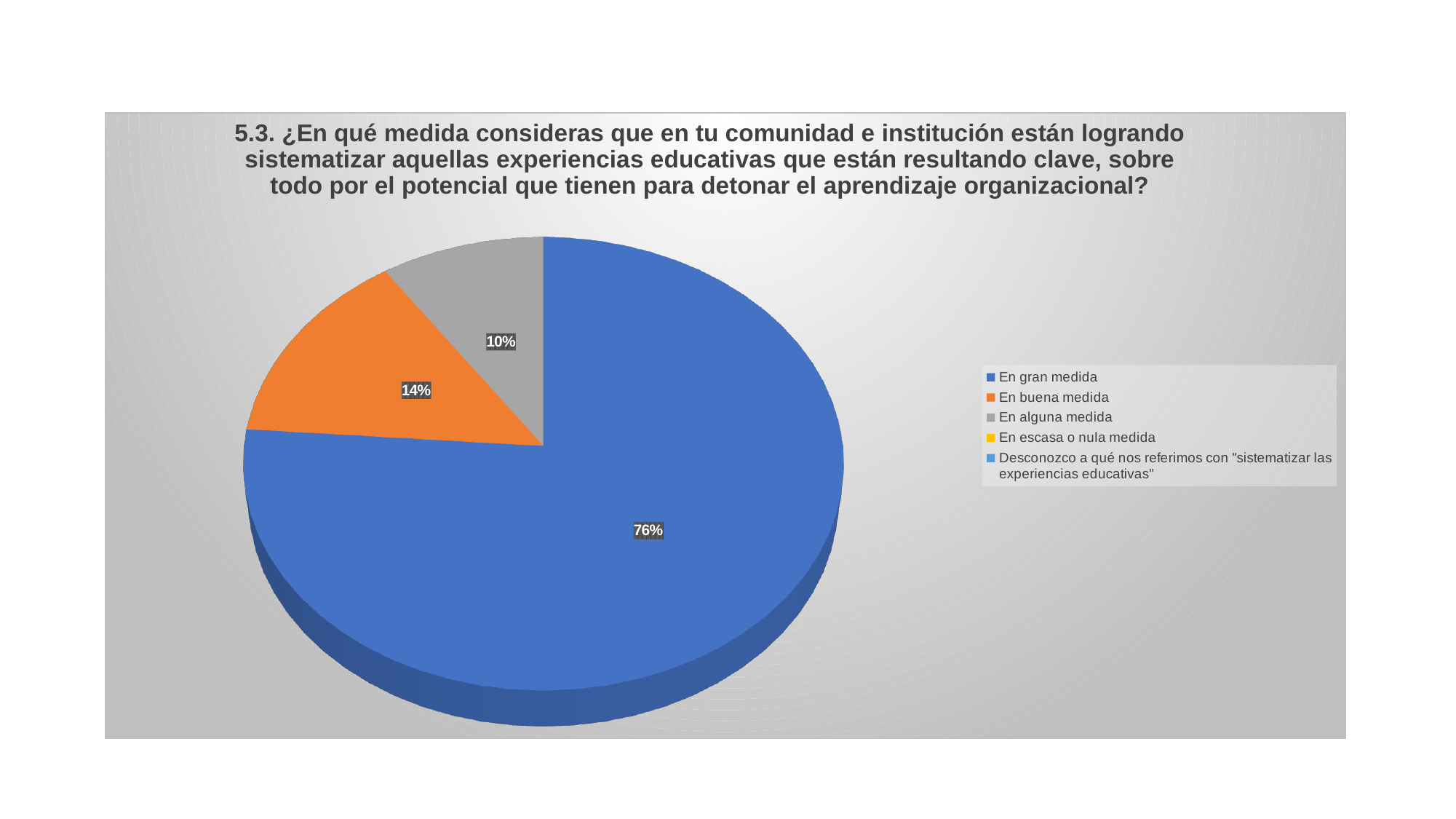
How many entries does the legend list? 5 Which is larger, the slice for "En buena medida" or the slice for "En alguna medida"? En buena medida What share of the pie does "En buena medida" represent? 14% Which category has the largest slice of the pie? En gran medida What is the difference in percentage points between "En gran medida" and "En buena medida"? 62 How many slices have a visible data label on the pie? 3 What share of the pie does "En gran medida" represent? 76% What share of the pie does "En alguna medida" represent? 10% Which of the labelled slices is the smallest? En alguna medida What colour is the slice for "En buena medida"? Orange What is the difference in percentage points between "En buena medida" and "En alguna medida"? 4 What kind of chart is shown on the slide? Pie chart